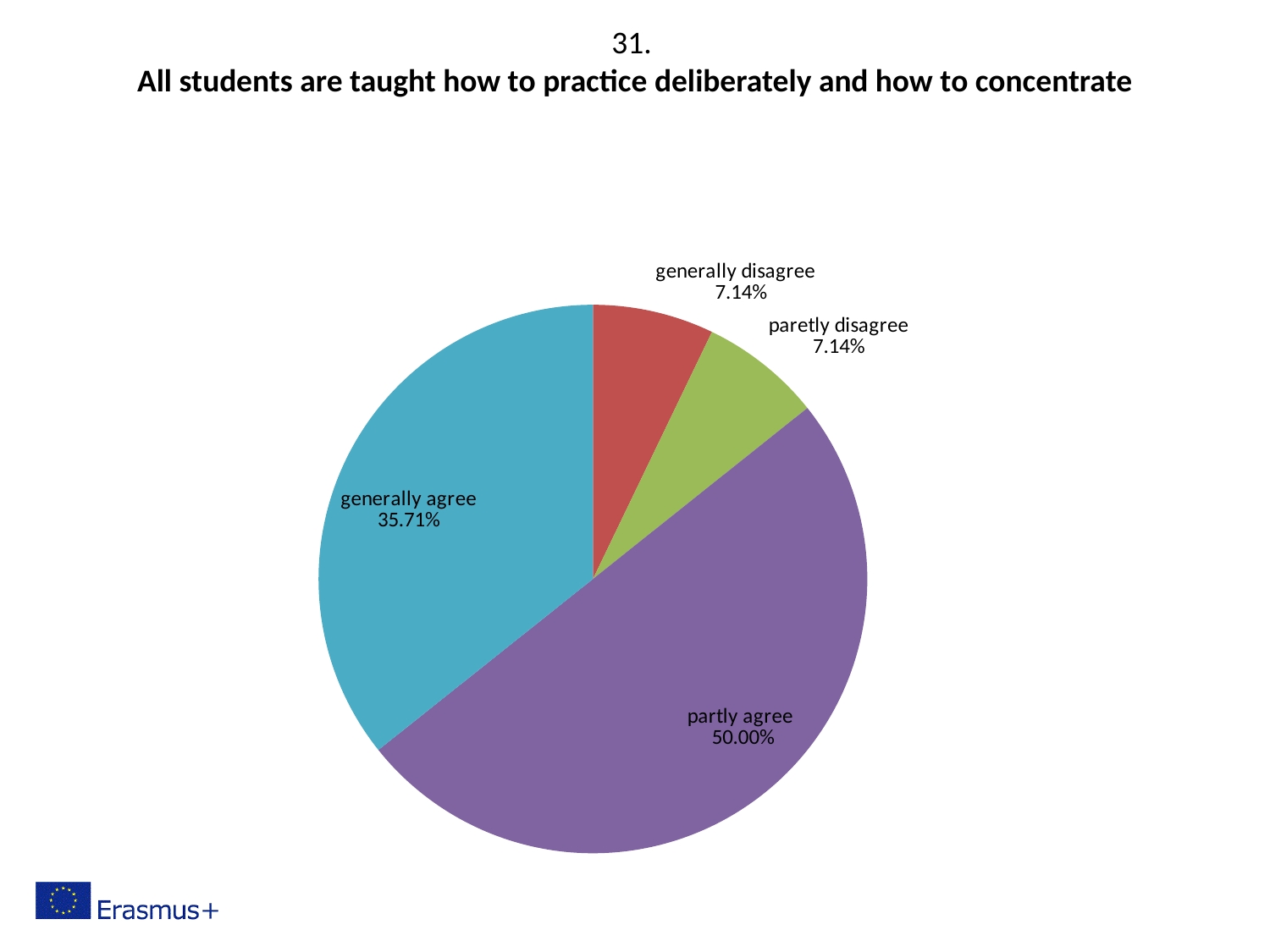
What percentage of respondents chose "generally disagree"? 7.14% How many slices does the pie chart have? 4 What is the combined share of "generally agree" and "partly agree"? 85.71% Which is larger, the share for "generally agree" or the share for "generally disagree"? generally agree Which response category has the largest share of the pie? partly agree What colour is the "partly agree" slice? purple What is the difference in percentage points between "partly agree" and "generally agree"? 14.29 What is the title of the statement shown above the chart? All students are taught how to practice deliberately and how to concentrate What percentage of respondents chose "generally agree"? 35.71% What kind of chart is shown on the slide? pie chart What percentage of respondents chose "partly agree"? 50.00% What percentage of respondents chose "paretly disagree"? 7.14%